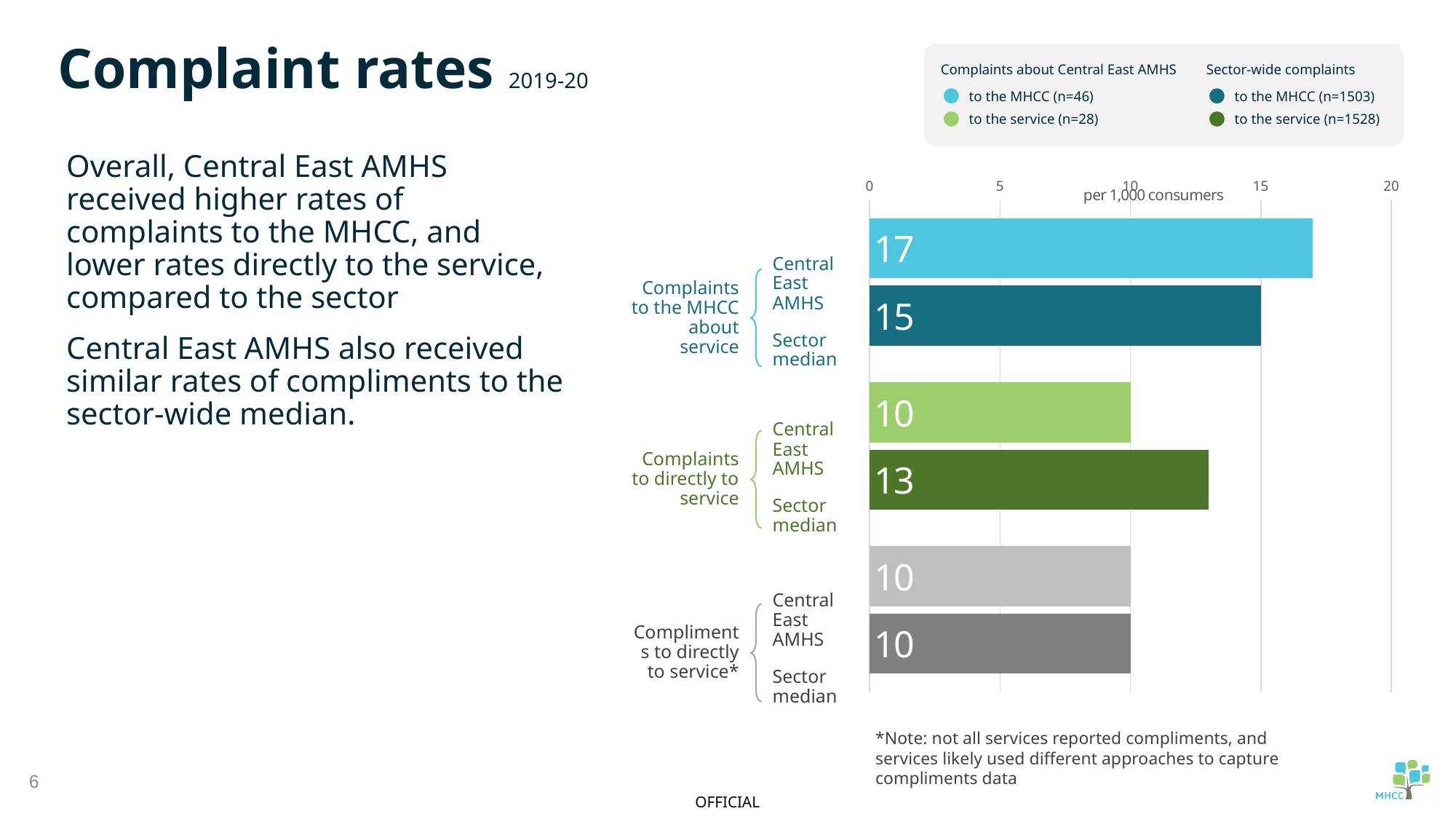
What is the difference between the sector median and Central East AMHS rates for complaints directly to service? 3 How many bars are plotted in the chart? 6 For complaints directly to service, which is larger: the Central East AMHS rate or the sector median? Sector median What is the difference between the Central East AMHS rate and the sector median rate for complaints to the MHCC about service? 2 What is the sector median rate of complaints directly to service? 13 What type of chart is shown on the slide? Bar chart What is the rate of complaints to the MHCC about service for Central East AMHS, per 1,000 consumers? 17 What is the sector median rate of complaints to the MHCC about service? 15 What is the rate of complaints directly to service for Central East AMHS? 10 What unit is the chart's axis measured in? per 1,000 consumers Which bar in the chart has the highest value? Central East AMHS complaints to the MHCC about service What is the rate of compliments directly to service for Central East AMHS? 10